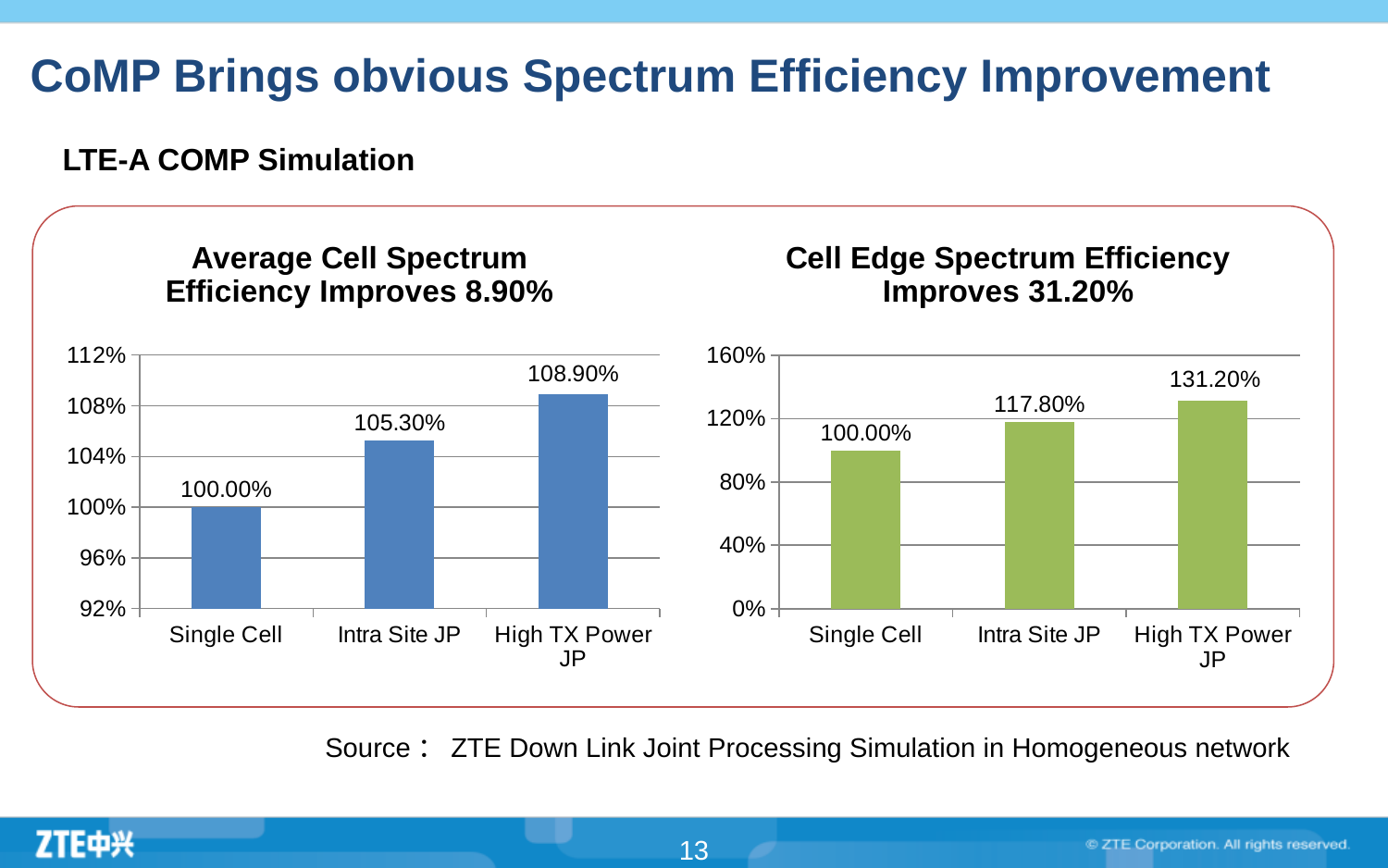
In the 'Average Cell Spectrum Efficiency Improves 8.90%' chart, what is the value for Intra Site JP? 105.30% What kind of chart is the 'Average Cell Spectrum Efficiency Improves 8.90%' chart? Bar chart In the 'Cell Edge Spectrum Efficiency Improves 31.20%' chart, which is larger, Intra Site JP or Single Cell? Intra Site JP In the 'Average Cell Spectrum Efficiency Improves 8.90%' chart, is the value for Intra Site JP greater or less than 104%? greater In the 'Cell Edge Spectrum Efficiency Improves 31.20%' chart, what is the difference between High TX Power JP and Intra Site JP? 13.40% In the 'Cell Edge Spectrum Efficiency Improves 31.20%' chart, what is the value for High TX Power JP? 131.20% In the 'Cell Edge Spectrum Efficiency Improves 31.20%' chart, what is the value for Intra Site JP? 117.80% In the 'Average Cell Spectrum Efficiency Improves 8.90%' chart, which category has the highest value? High TX Power JP In the 'Cell Edge Spectrum Efficiency Improves 31.20%' chart, which category has the lowest value? Single Cell In the 'Average Cell Spectrum Efficiency Improves 8.90%' chart, what is the difference between High TX Power JP and Single Cell? 8.90% How many categories are shown in the 'Cell Edge Spectrum Efficiency Improves 31.20%' chart? 3 In the 'Cell Edge Spectrum Efficiency Improves 31.20%' chart, do the values rise or fall from Single Cell to High TX Power JP? Rise